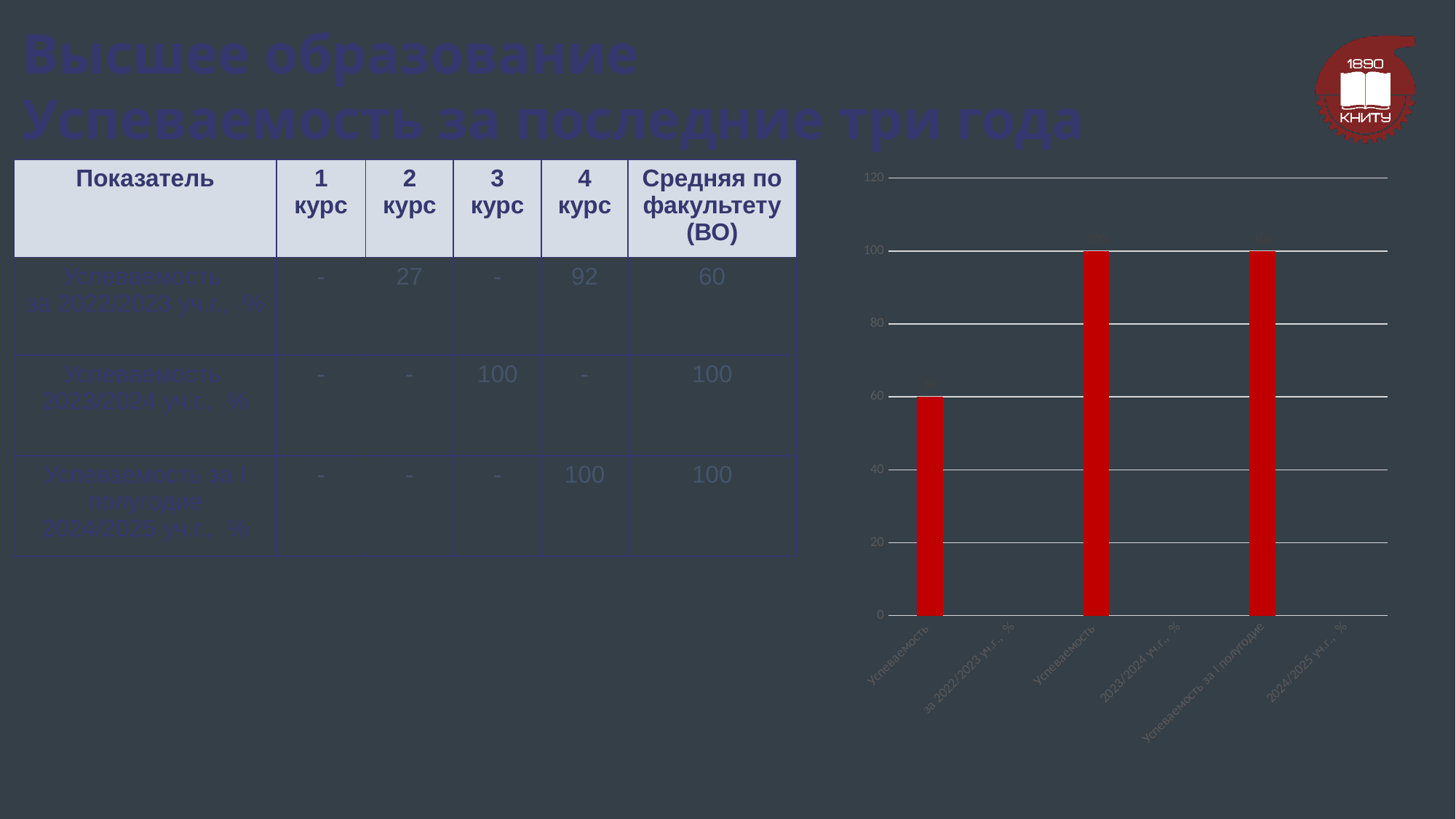
Is the value of the third bar greater or less than 80? greater Is the value of the first bar greater or less than 80? less Which bar in the chart is the lowest? the first (leftmost) bar, Успеваемость за 2022/2023 уч.г., % What is the value of the first (leftmost) bar in the chart? 60 What kind of chart is shown on the right side of the slide? bar chart What is the highest value shown on the vertical axis of the chart? 120 What is the difference between the second bar and the first bar in the chart? 40 What is the value of the second bar in the chart? 100 What is the value of the third (rightmost) bar in the chart? 100 What colour are the bars in the chart? red How many bars are plotted in the chart? 3 Which is larger in the chart: the first bar or the second bar? the second bar